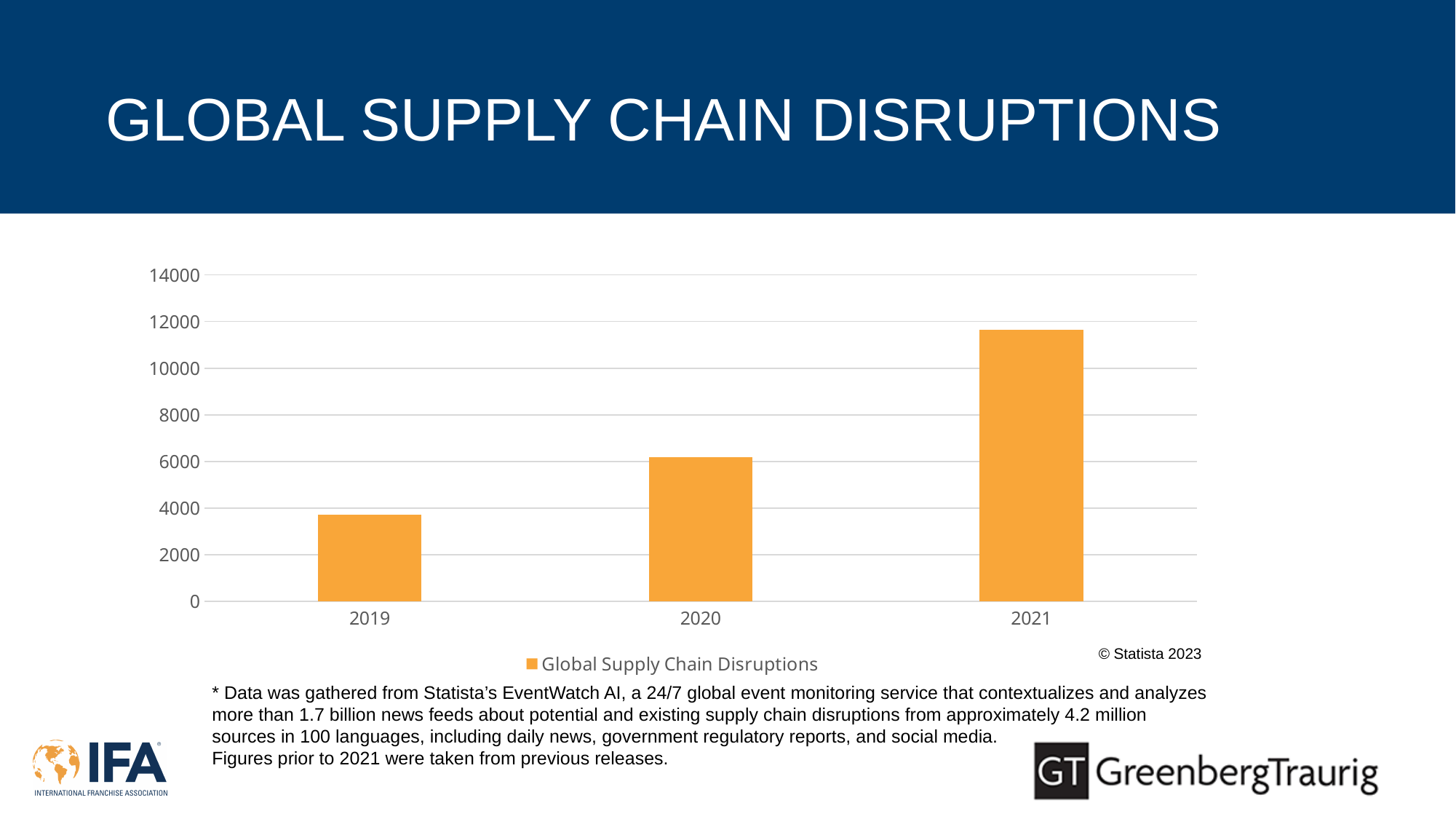
What kind of chart is shown on the slide? bar chart Which year has the highest number of global supply chain disruptions? 2021 How many years are shown on the x axis of the chart? 3 What is the name of the series shown in the chart's legend? Global Supply Chain Disruptions Is the value for 2019 greater or less than 4000? less Which year has the lowest number of global supply chain disruptions? 2019 Which is larger, the value for 2020 or the value for 2019? 2020 Is the value for 2021 greater or less than 10000? greater How many series does the chart's legend list? 1 Is the value for 2021 greater or less than 12000? less Do the values rise or fall from 2019 to 2021? rise